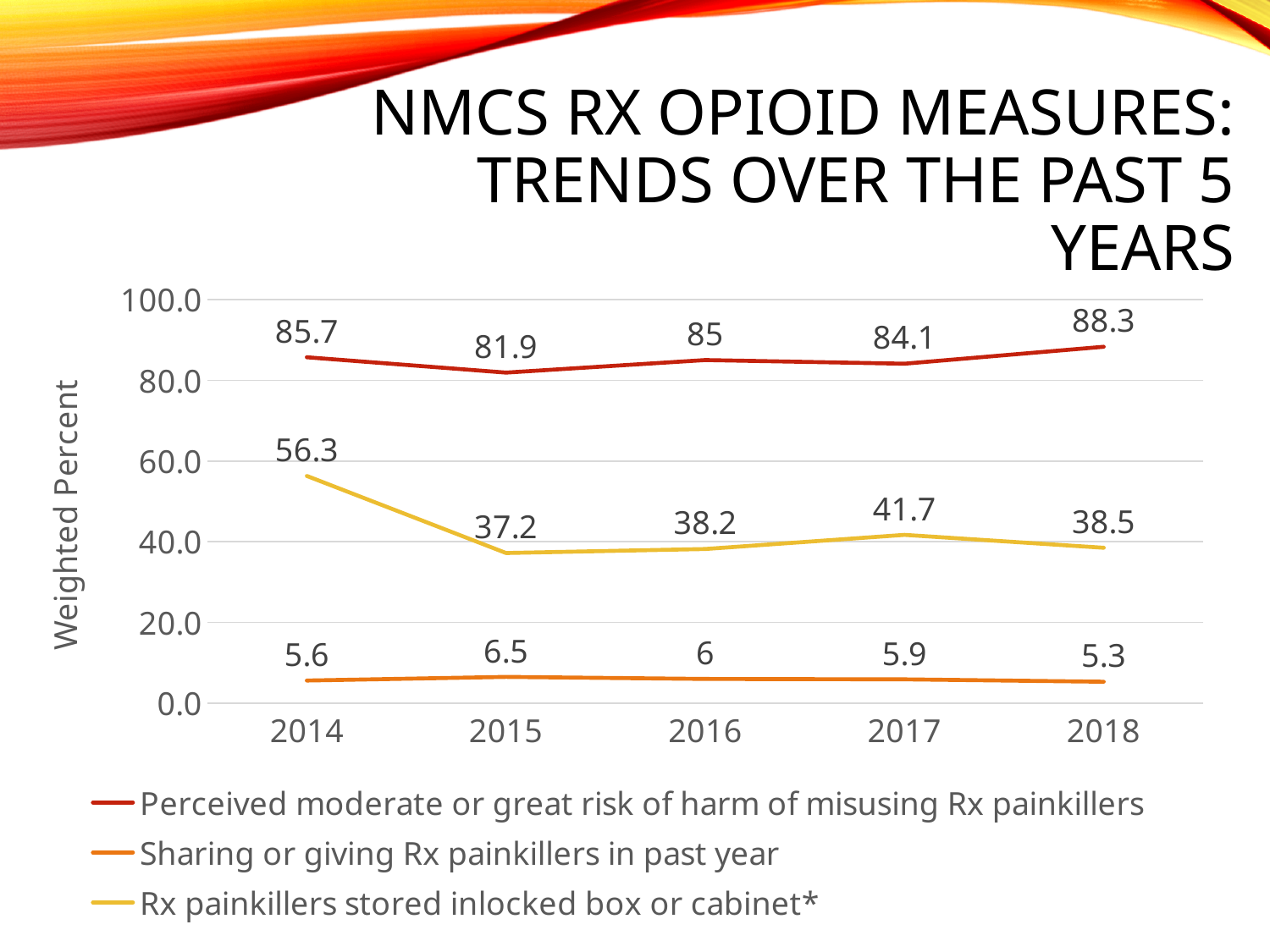
In which year is 'Perceived moderate or great risk of harm of misusing Rx painkillers' lowest? 2015 Which is larger for 'Sharing or giving Rx painkillers in past year': the 2015 value or the 2018 value? 2015 What is the value for 'Rx painkillers stored inlocked box or cabinet*' in 2014? 56.3 What kind of chart is shown on the slide? Line chart How many series does the legend list? 3 What is the difference between the 2014 and 2015 values for 'Rx painkillers stored inlocked box or cabinet*'? 19.1 In which year is 'Rx painkillers stored inlocked box or cabinet*' highest? 2014 What is the value for 'Perceived moderate or great risk of harm of misusing Rx painkillers' in 2018? 88.3 What is the value for 'Sharing or giving Rx painkillers in past year' in 2015? 6.5 Does 'Rx painkillers stored inlocked box or cabinet*' rise or fall from 2014 to 2015? Fall How many years are shown on the x axis? 5 What is the label of the y axis? Weighted Percent